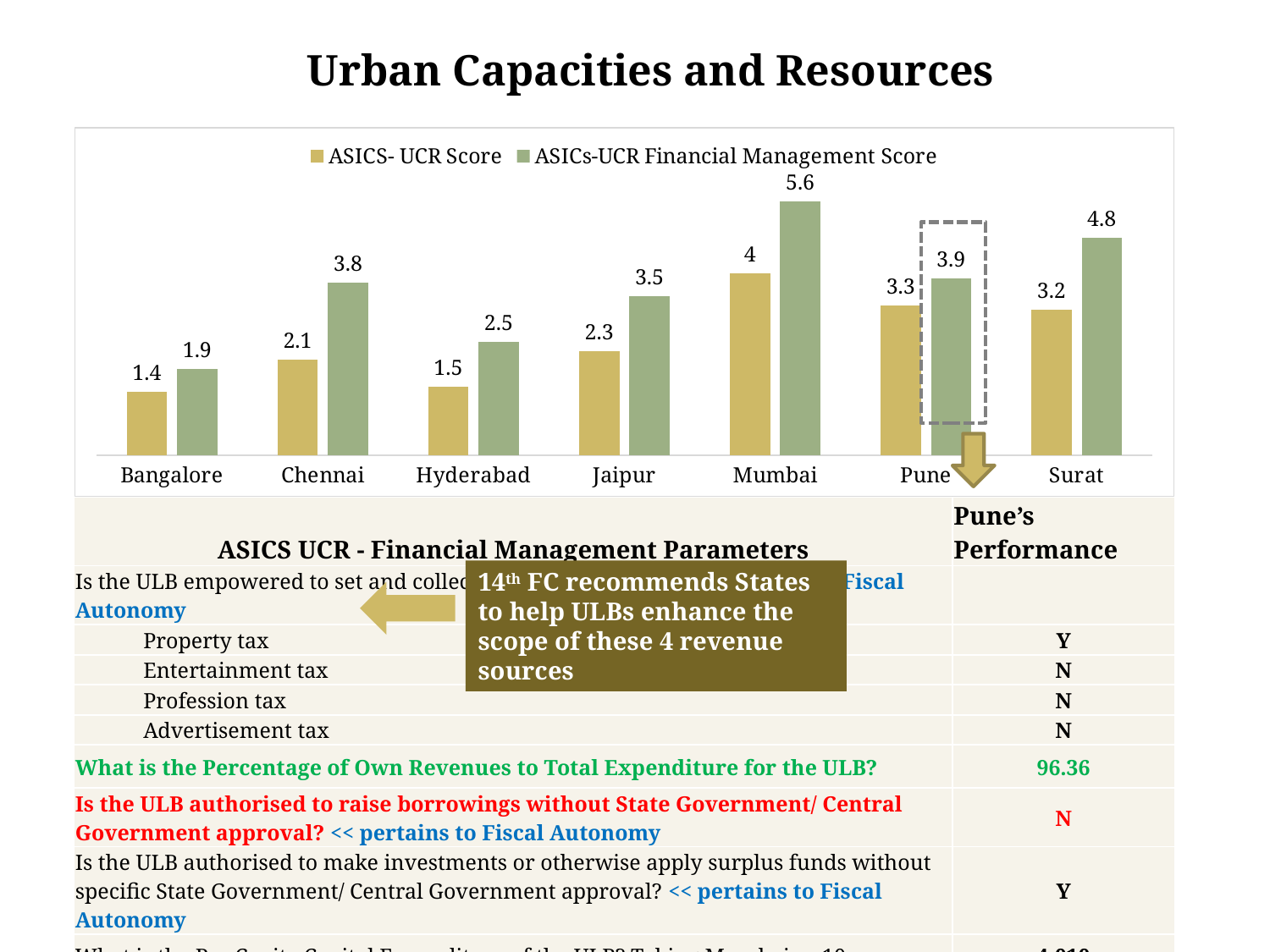
Which city's bars are highlighted with a dashed box on the chart? Pune What is the difference between the ASICs-UCR Financial Management Score for Mumbai and for Pune? 1.7 What kind of chart is shown on the slide? Bar chart What is the difference between the ASICs-UCR Financial Management Score and the ASICS-UCR Score for Chennai? 1.7 What is the ASICs-UCR Financial Management Score for Surat? 4.8 Which city has the lowest ASICs-UCR Financial Management Score? Bangalore Which is larger, the ASICS-UCR Score for Jaipur or the ASICS-UCR Score for Hyderabad? Jaipur How many cities are shown on the chart? 7 How many series does the chart legend list? 2 Which city has the highest ASICS-UCR Score? Mumbai What is the ASICS-UCR Score for Pune? 3.3 What is the ASICs-UCR Financial Management Score for Mumbai? 5.6